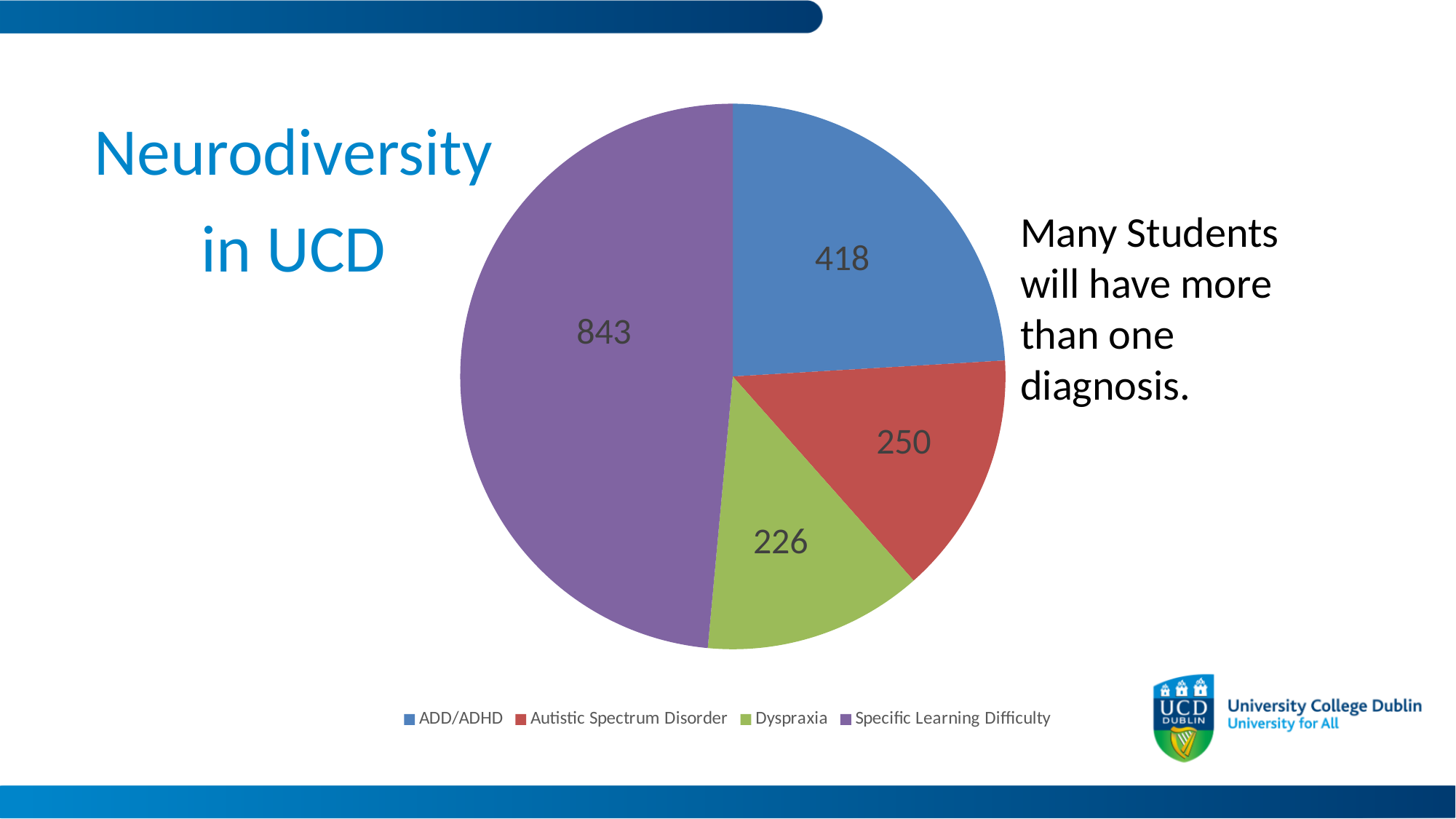
What is the total of all the slices in the pie chart? 1737 Which category has the smallest slice of the pie? Dyspraxia Which is larger, the value for ADD/ADHD or the value for Autistic Spectrum Disorder? ADD/ADHD Which category has the largest slice of the pie? Specific Learning Difficulty Which colour represents Dyspraxia in the pie chart? green What is the value for Dyspraxia? 226 What is the value for Specific Learning Difficulty? 843 How many categories does the pie chart show? 4 What is the value for ADD/ADHD? 418 What kind of chart is shown on the slide? pie chart What is the value for Autistic Spectrum Disorder? 250 What is the difference between the values for Specific Learning Difficulty and ADD/ADHD? 425